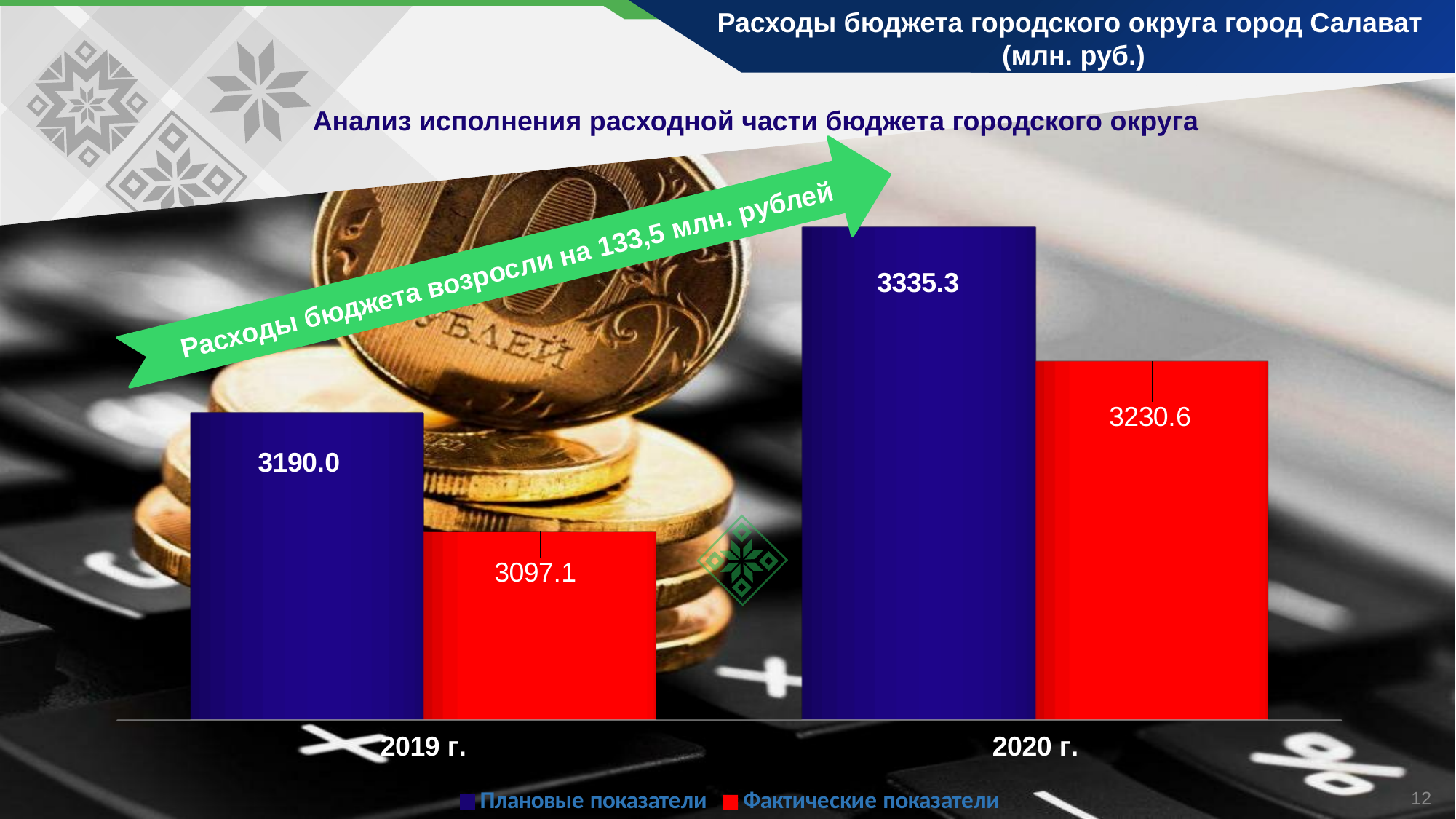
Which bar has the highest value on the chart? Плановые показатели, 2020 г. What is the difference between Плановые показатели and Фактические показатели for 2020 г.? 104.7 Which is larger for 2019 г.: Плановые показатели or Фактические показатели? Плановые показатели What is the value of Плановые показатели for 2019 г.? 3190.0 How many categories are shown on the x axis? 2 Which bar has the lowest value on the chart? Фактические показатели, 2019 г. What is the value of Фактические показатели for 2019 г.? 3097.1 What is the difference between Фактические показатели for 2020 г. and 2019 г.? 133.5 What is the value of Фактические показатели for 2020 г.? 3230.6 What kind of chart is shown on the slide? Bar chart How many series does the legend list? 2 What is the value of Плановые показатели for 2020 г.? 3335.3